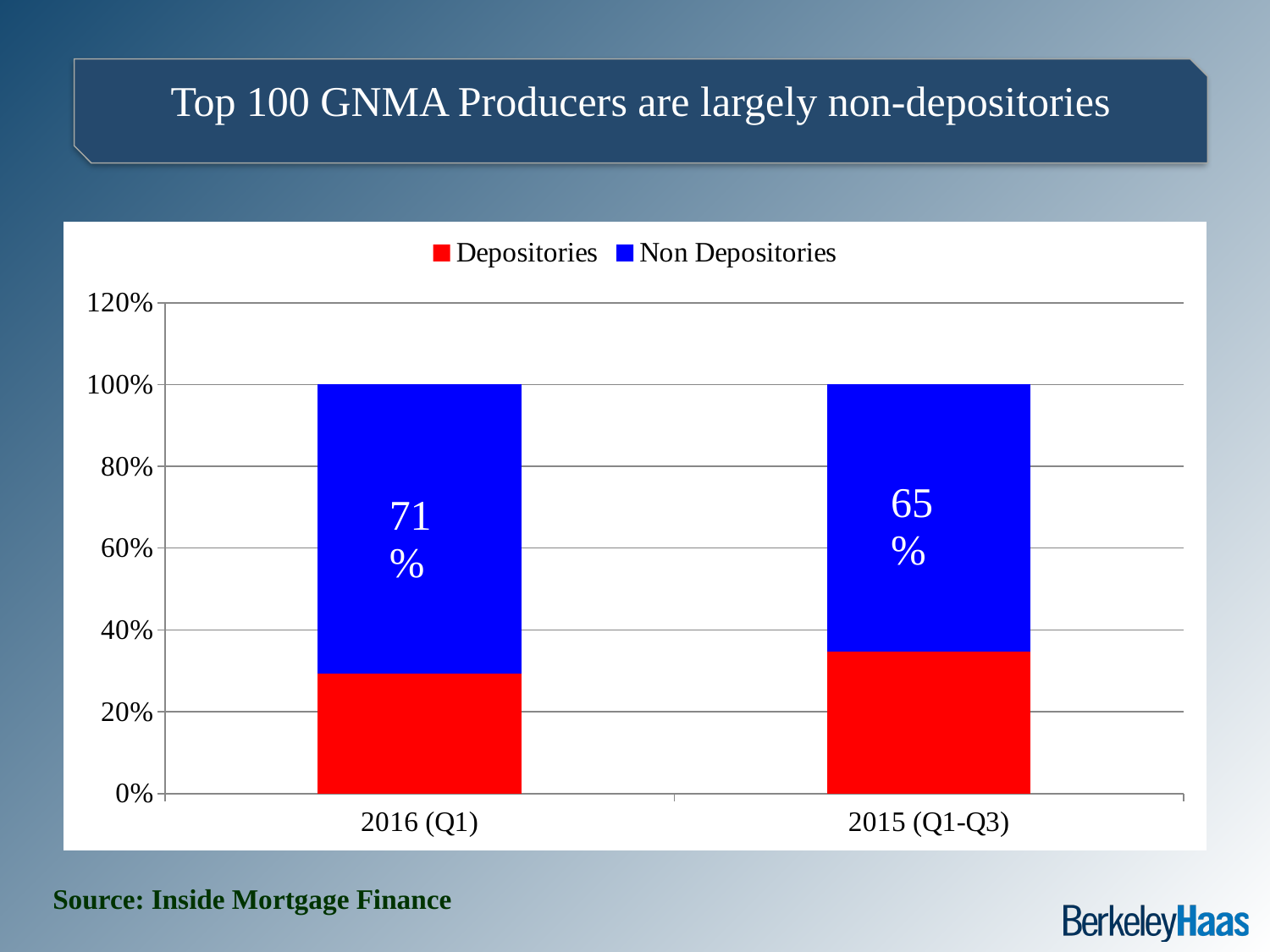
How many series does the legend list? 2 Which period has the higher Non Depositories share? 2016 (Q1) What kind of chart is shown on the slide? Stacked bar chart Which period has the lower Non Depositories share? 2015 (Q1-Q3) How many periods are shown on the x axis? 2 Is the Depositories share for 2015 (Q1-Q3) greater or less than 20%? greater Is the Depositories share larger in 2016 (Q1) or in 2015 (Q1-Q3)? 2015 (Q1-Q3) Which colour represents Non Depositories in the chart? Blue What is the difference between the Non Depositories share in 2016 (Q1) and in 2015 (Q1-Q3)? 6 percentage points What is the Non Depositories share for 2015 (Q1-Q3)? 65% What is the Non Depositories share for 2016 (Q1)? 71% Is the Depositories share for 2016 (Q1) greater or less than 40%? less